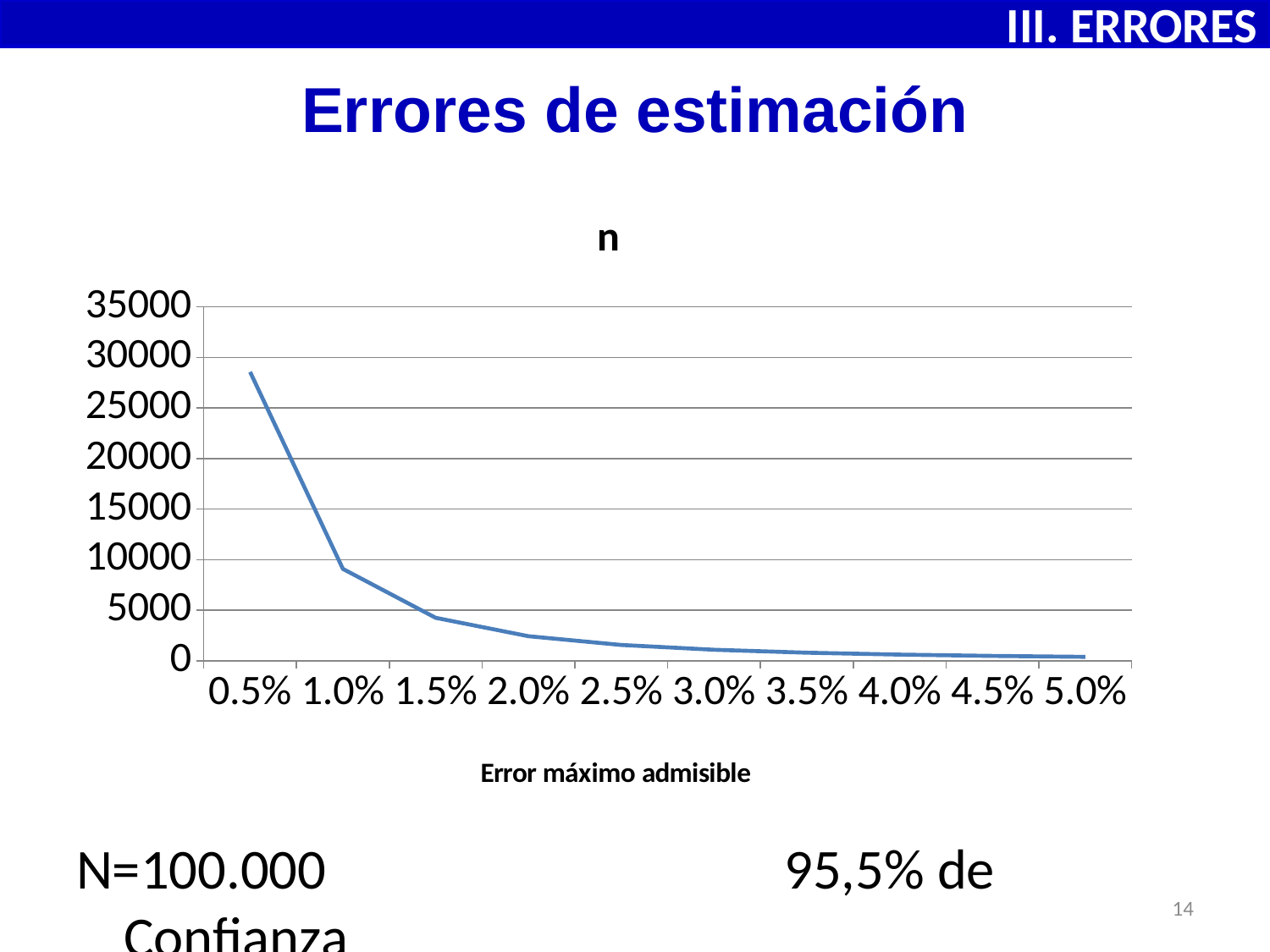
Which error máximo admisible has the highest value of n? 0.5% What is the label of the x axis? Error máximo admisible Which has a larger value of n, 1.0% or 2.0%? 1.0% Is the value for 0.5% greater or less than 30000? less Is the value for 1.0% greater or less than 5000? greater Which error máximo admisible has the lowest value of n? 5.0% Is the value for 0.5% greater or less than 25000? greater What is the title of the chart? n How many points are plotted along the x axis? 10 What kind of chart is shown on the slide? line chart Do the values rise or fall as the error máximo admisible increases along the x axis? fall